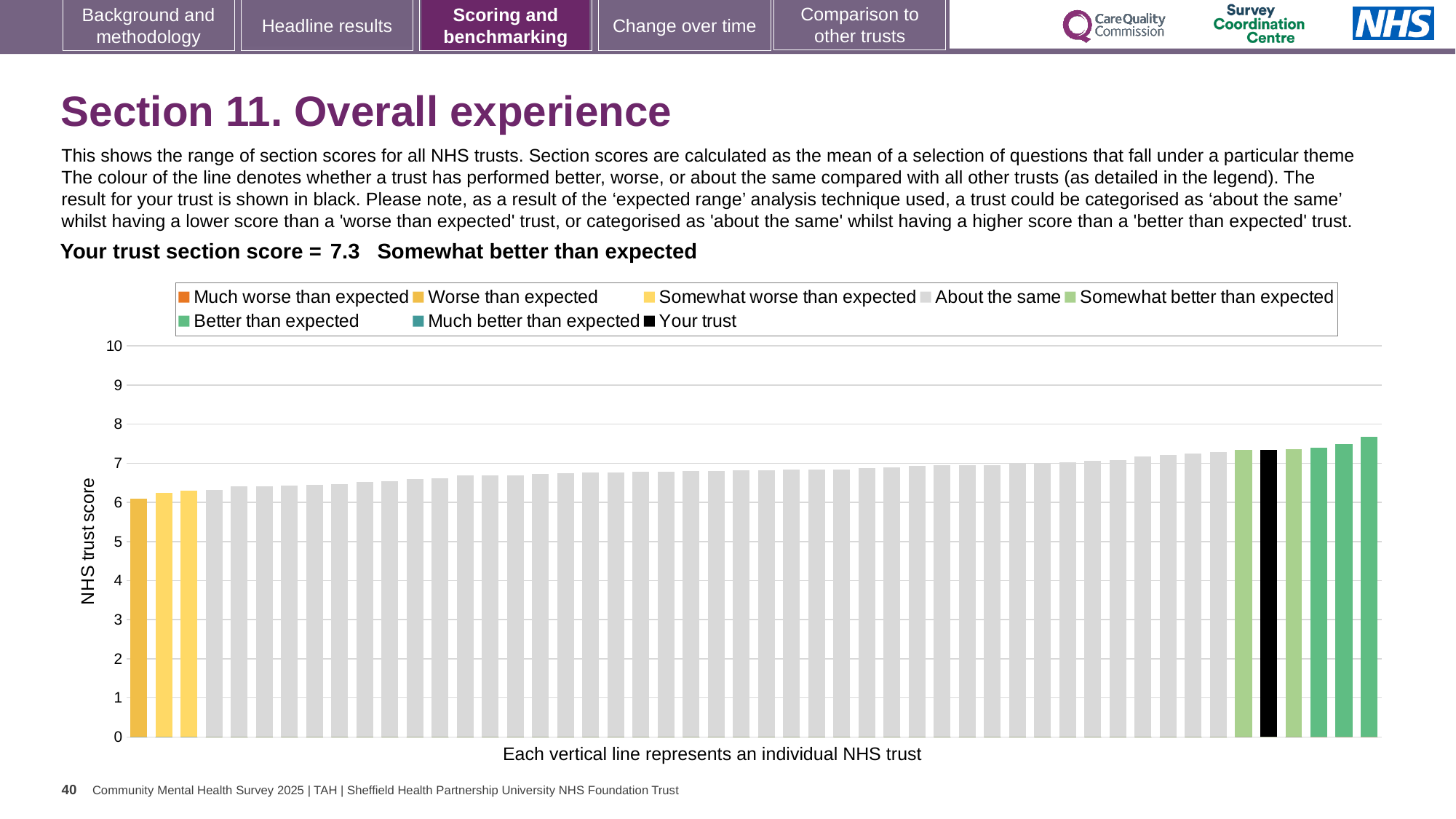
Which legend category does the shortest bar in the chart belong to? Worse than expected How many entries does the chart legend list? 8 Is the value of the black 'Your trust' bar greater or less than 7? greater Which legend category does the tallest bar in the chart belong to? Better than expected What kind of chart is shown on the slide? bar chart What is the label on the vertical axis of the chart? NHS trust score Is the black 'Your trust' bar taller or shorter than the rightmost bar? shorter Do the bar values rise or fall from left to right along the x axis? rise What is the section score for your trust, as stated on the slide? 7.3 Is the value of the rightmost (highest) bar greater or less than 8? less What colour is used for the 'Your trust' bar in the chart? black